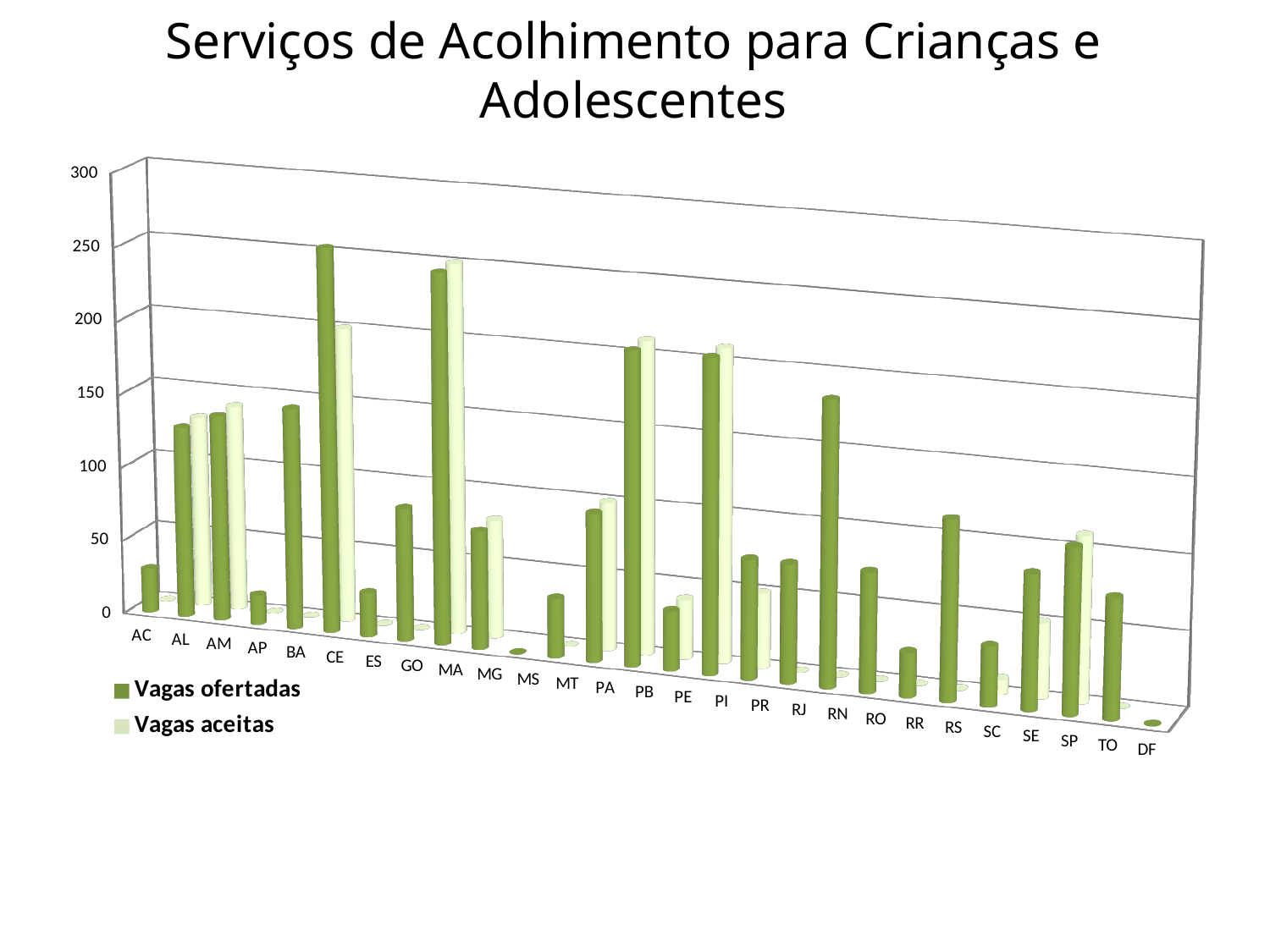
Which is larger, the Vagas ofertadas value for PB or for PE? PB What is the title of the chart? Serviços de Acolhimento para Crianças e Adolescentes How many series does the legend list? 2 Which is larger, the Vagas ofertadas value for RN or for RO? RN Which category has the highest value for Vagas ofertadas? CE Is the Vagas ofertadas value for RN greater or less than 100? greater Is the Vagas ofertadas value for AC greater or less than 50? less What are the two series named in the legend? Vagas ofertadas and Vagas aceitas What kind of chart is shown on the slide? bar chart Is the Vagas ofertadas value for CE greater or less than 200? greater How many categories (states) are shown on the x axis? 27